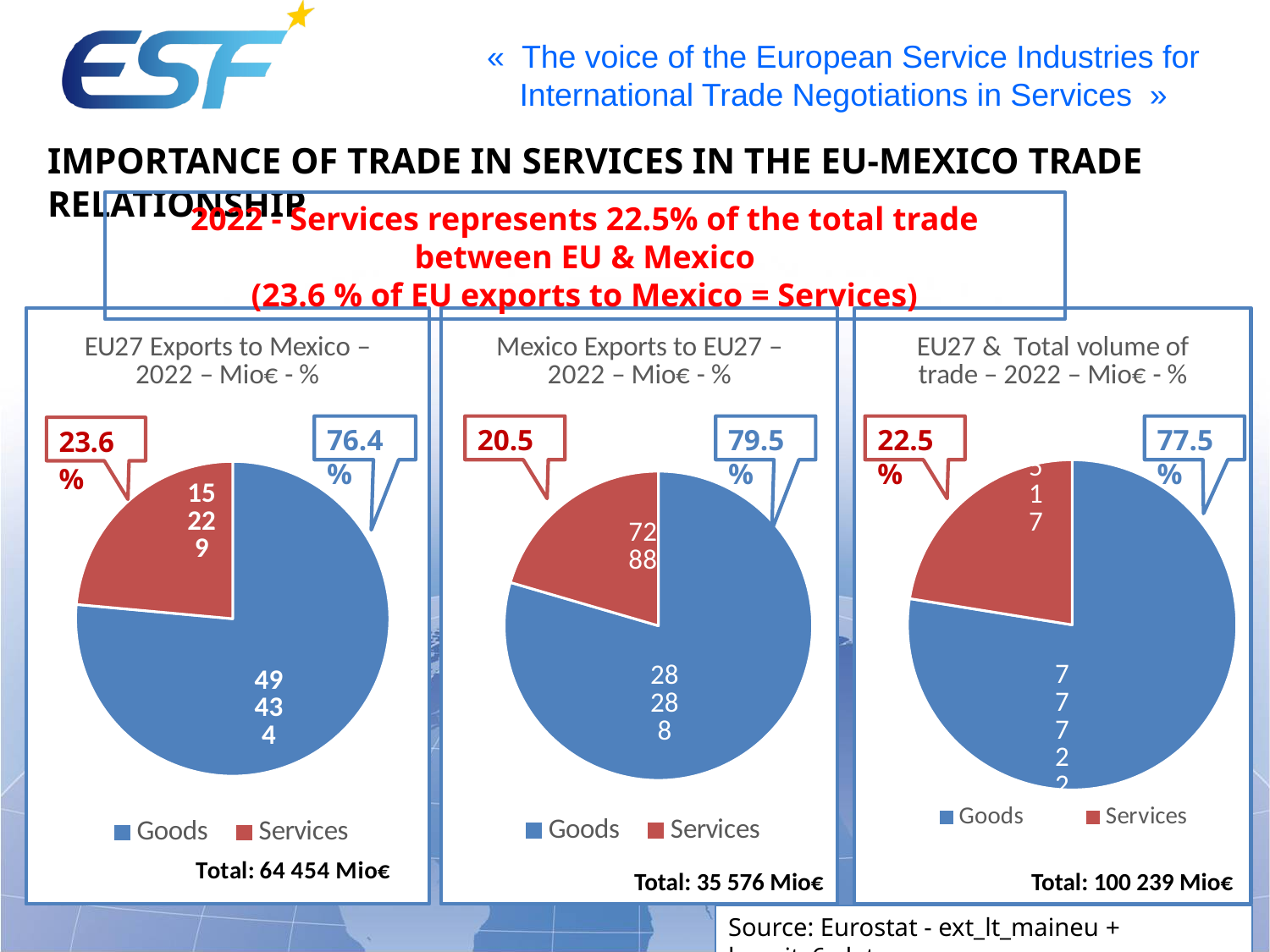
In the 'Mexico Exports to EU27 – 2022' chart, what is the value for Goods? 28 288 In the 'EU27 Exports to Mexico – 2022' chart, what share of the pie is Services? 23.6% What total is printed below the 'EU27 Exports to Mexico – 2022' chart? 64 454 Mio€ What total is printed below the 'EU27 & Total volume of trade – 2022' chart? 100 239 Mio€ In the 'Mexico Exports to EU27 – 2022' chart, what share of the pie is Services? 20.5% In the 'EU27 & Total volume of trade – 2022' chart, what share of the pie is Goods? 77.5% In the 'Mexico Exports to EU27 – 2022' chart, which slice is larger, Goods or Services? Goods In the 'Mexico Exports to EU27 – 2022' chart, what is the value for Services? 7 288 How many categories does the legend of the 'Mexico Exports to EU27 – 2022' chart list? 2 In the 'EU27 Exports to Mexico – 2022' chart, which colour represents Services? Red What kind of chart is used in the 'EU27 Exports to Mexico – 2022' chart? Pie chart